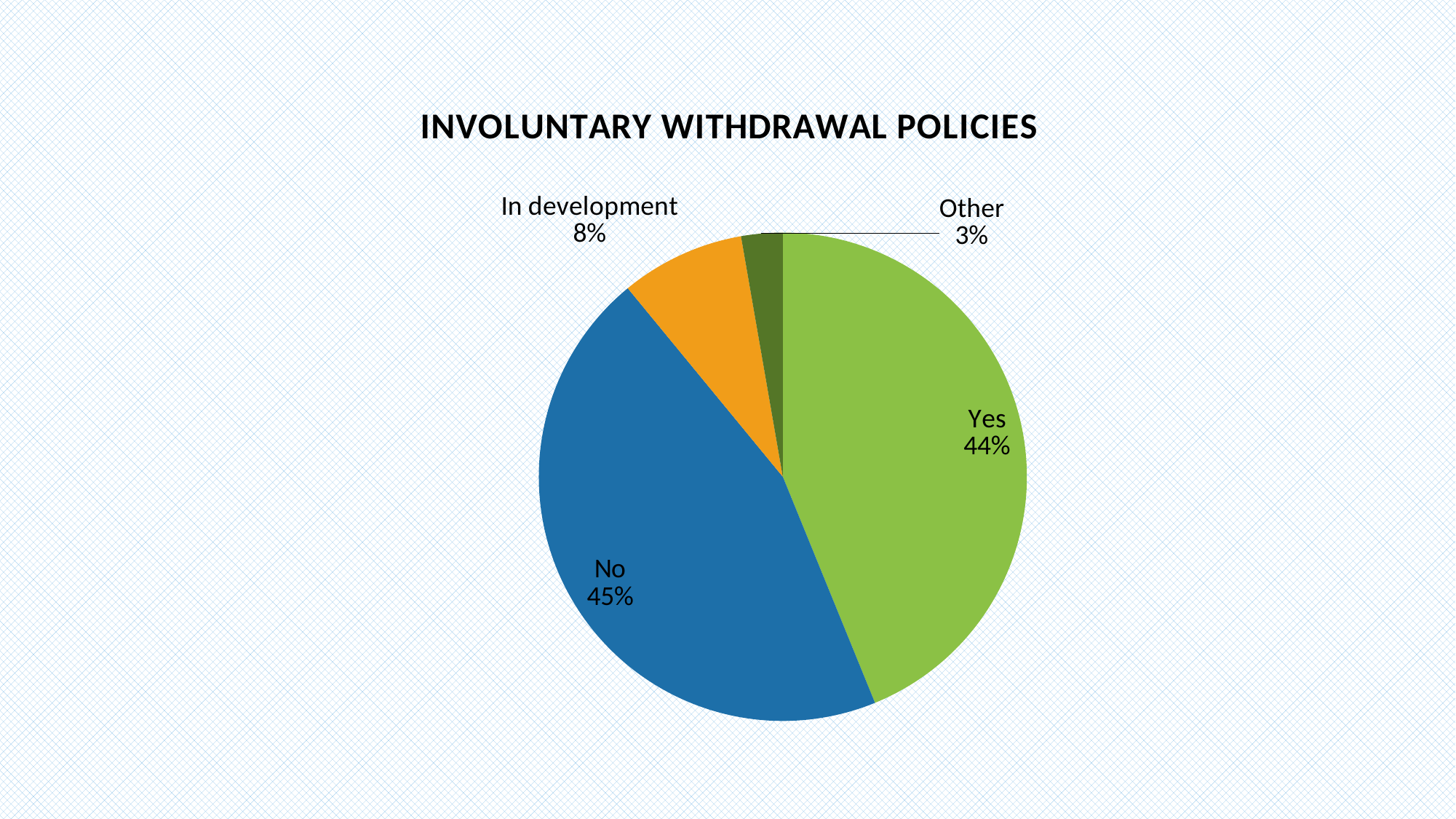
What percentage is shown for "In development"? 8% What share of the pie is labelled "Yes"? 44% What colour is the "No" slice? Blue Which category has the smallest slice of the pie? Other Which is larger, the "In development" slice or the "Other" slice? In development What kind of chart is shown on the slide? Pie chart What share of the pie is labelled "No"? 45% What is the difference in percentage points between "In development" and "Other"? 5% What is the title of the pie chart? INVOLUNTARY WITHDRAWAL POLICIES How many slices does the pie chart have? 4 What percentage is shown for "Other"? 3% What is the difference in percentage points between "No" and "Yes"? 1%